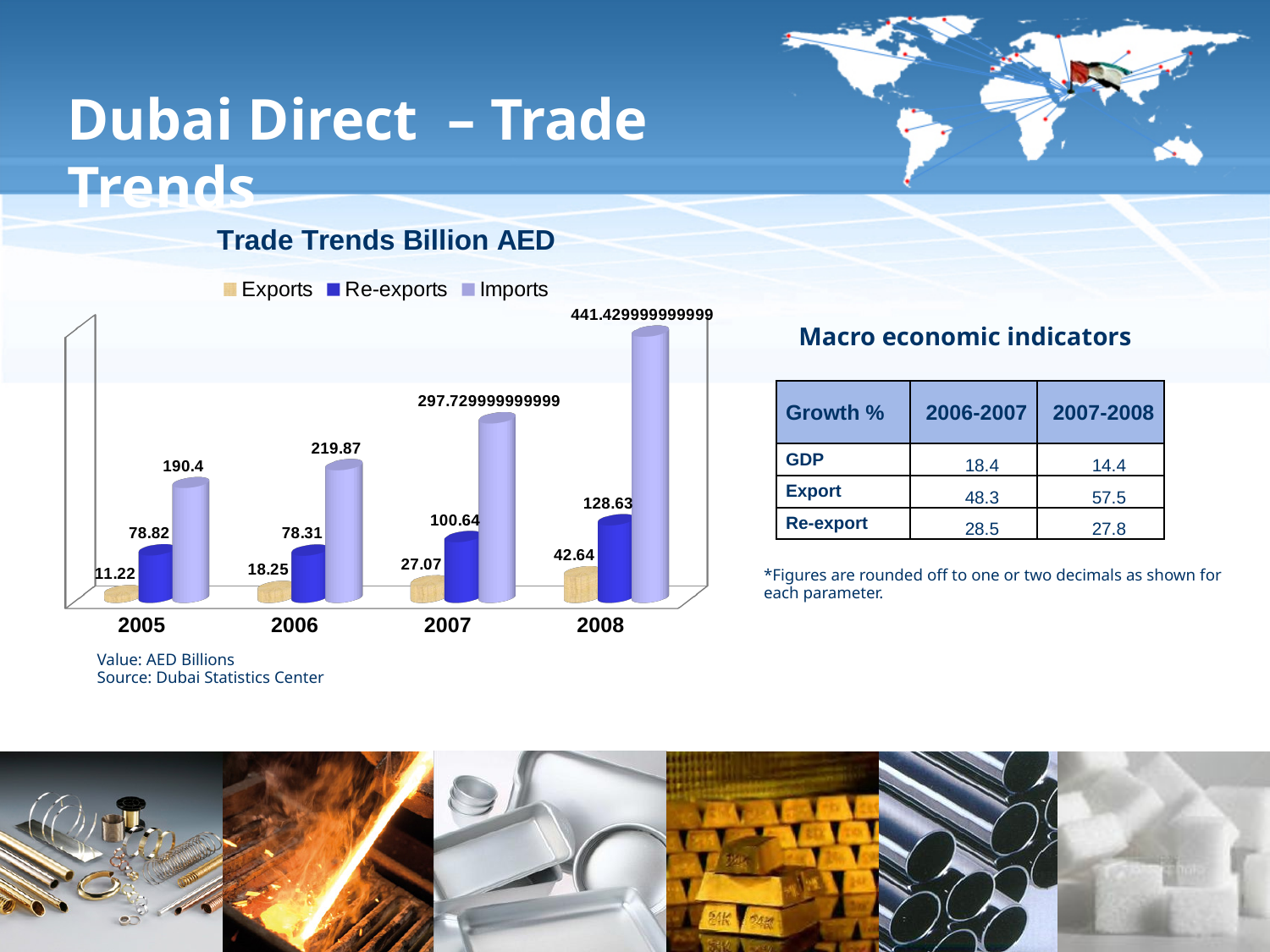
What is the value for Re-exports in 2007? 100.64 How many series does the chart's legend list? 3 How many years are shown on the x axis of the chart? 4 Do the Imports values rise or fall from 2005 to 2008? Rise What is the value for Exports in 2005? 11.22 Which is larger, Exports in 2008 or Exports in 2007? Exports in 2008 Which year has the lowest Exports value? 2005 What is the difference between Re-exports in 2008 and Re-exports in 2007? 27.99 What kind of chart is shown on the slide? Bar chart Which year has the highest Imports value? 2008 What is the value for Imports in 2006? 219.87 What is the value for Imports in 2008 as printed on the chart? 441.429999999999